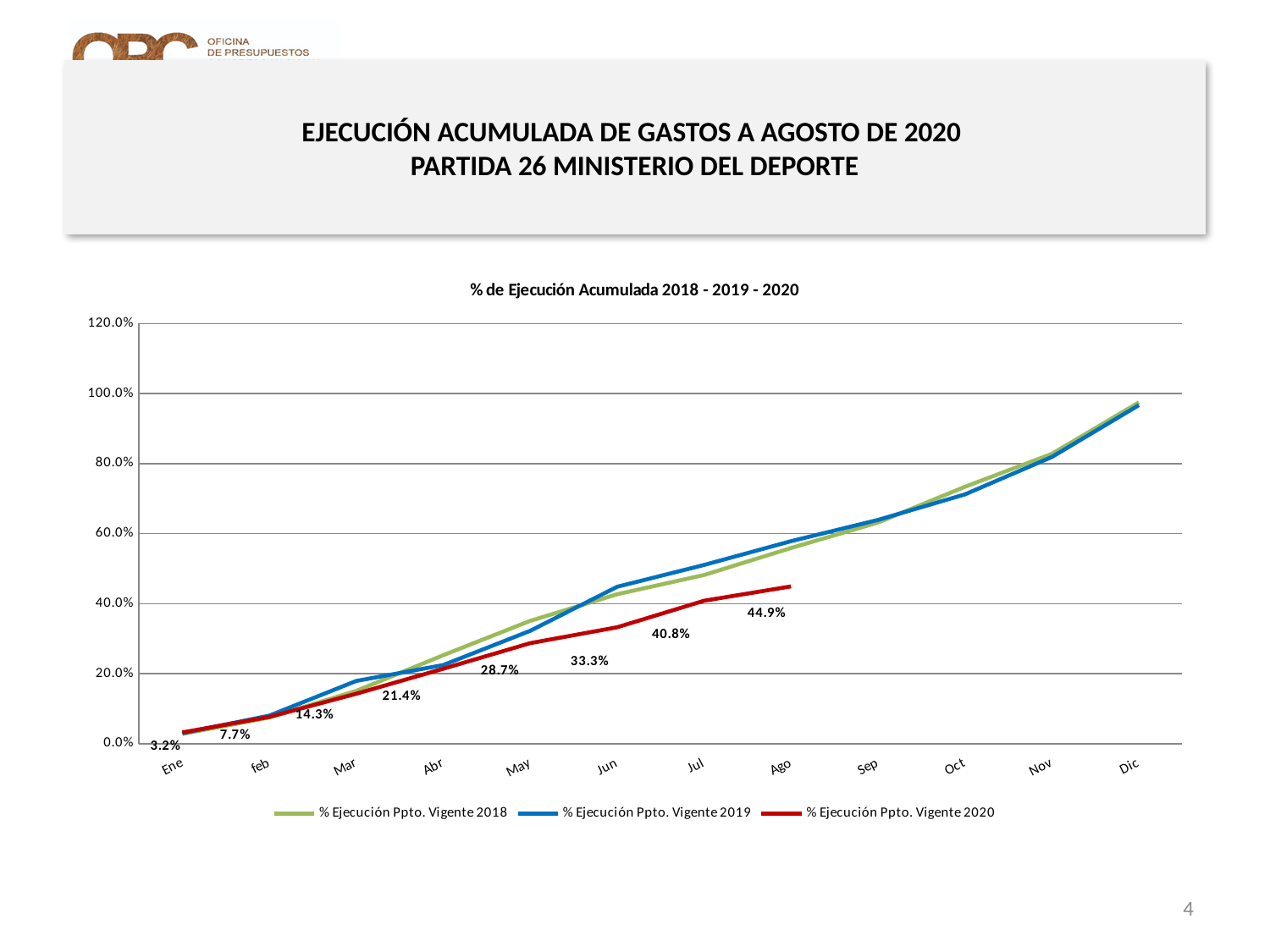
What is the value for % Ejecución Ppto. Vigente 2020 in Ago? 44.9% In which month does the % Ejecución Ppto. Vigente 2020 series reach its highest labelled value? Ago What is the difference between the 2020 values for Ago and Jul? 4.1% How many series does the legend list? 3 What type of chart is shown on the slide? line chart What is the value for % Ejecución Ppto. Vigente 2020 in Abr? 21.4% How many months are shown on the x axis? 12 In which month does the % Ejecución Ppto. Vigente 2020 series have its lowest value? Ene In Jun, which series has the larger value: % Ejecución Ppto. Vigente 2019 or % Ejecución Ppto. Vigente 2020? % Ejecución Ppto. Vigente 2019 What is the value for % Ejecución Ppto. Vigente 2020 in Ene? 3.2% Do the values of the % Ejecución Ppto. Vigente 2020 series rise or fall from Ene to Ago? rise Is the value for % Ejecución Ppto. Vigente 2019 in Dic greater or less than 80%? greater